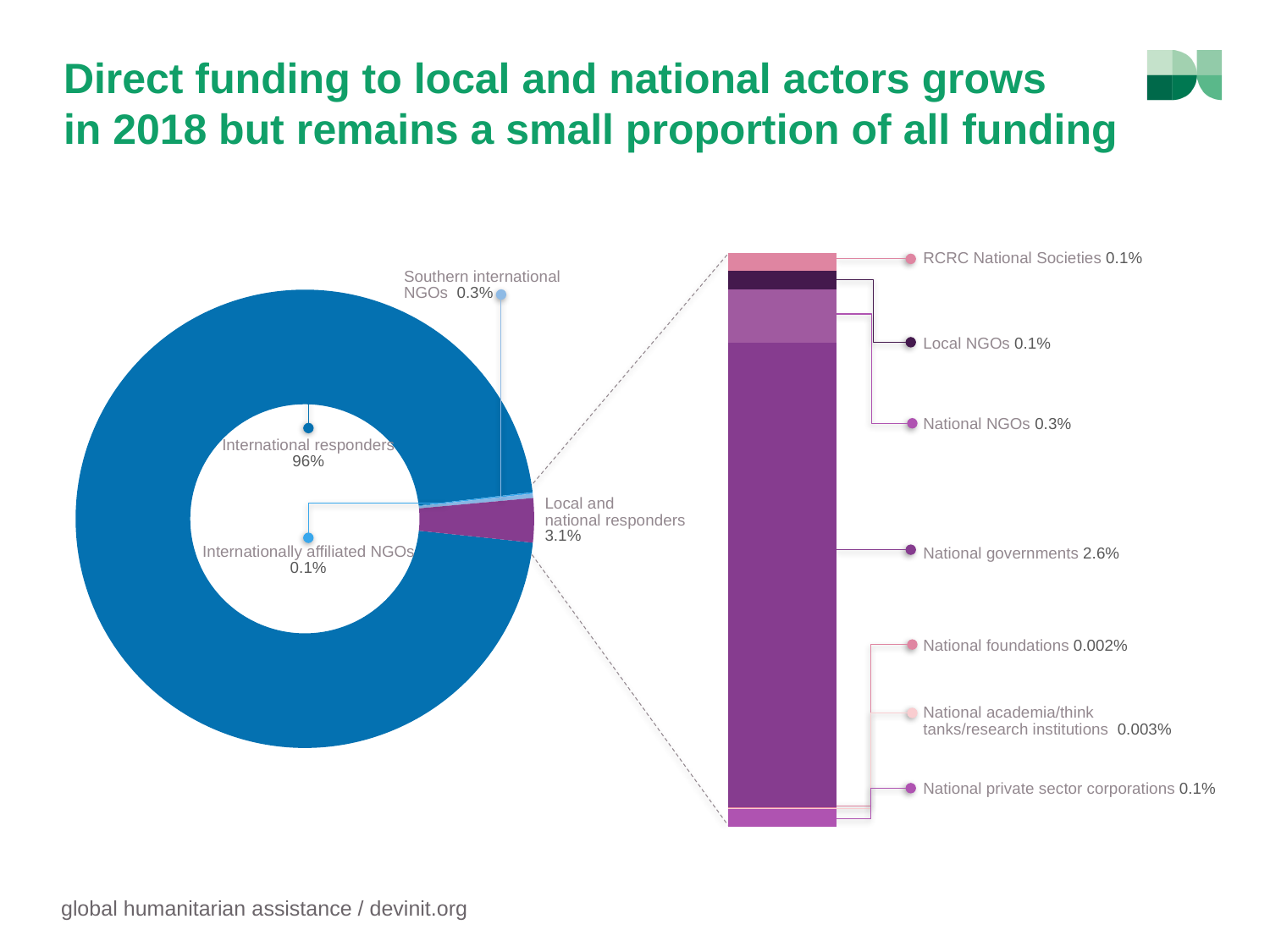
In the donut chart on the left, what is the value for Southern international NGOs? 0.3% In the donut chart on the left, which category has the largest share? International responders What kind of chart is shown on the left of the slide? Donut (pie) chart In the stacked bar breakdown on the right, what is the value for National governments? 2.6% In the donut chart on the left, what share of funding goes to Local and national responders? 3.1% In the donut chart on the left, what is the value for Internationally affiliated NGOs? 0.1% In the stacked bar breakdown on the right, how many categories are labelled? 7 In the stacked bar breakdown on the right, what is the value for National NGOs? 0.3% In the stacked bar breakdown on the right, which category has the smallest value? National foundations In the stacked bar breakdown on the right, which category has the largest value? National governments In the stacked bar breakdown on the right, what is the value for National foundations? 0.002% In the donut chart on the left, what share of funding goes to International responders? 96%